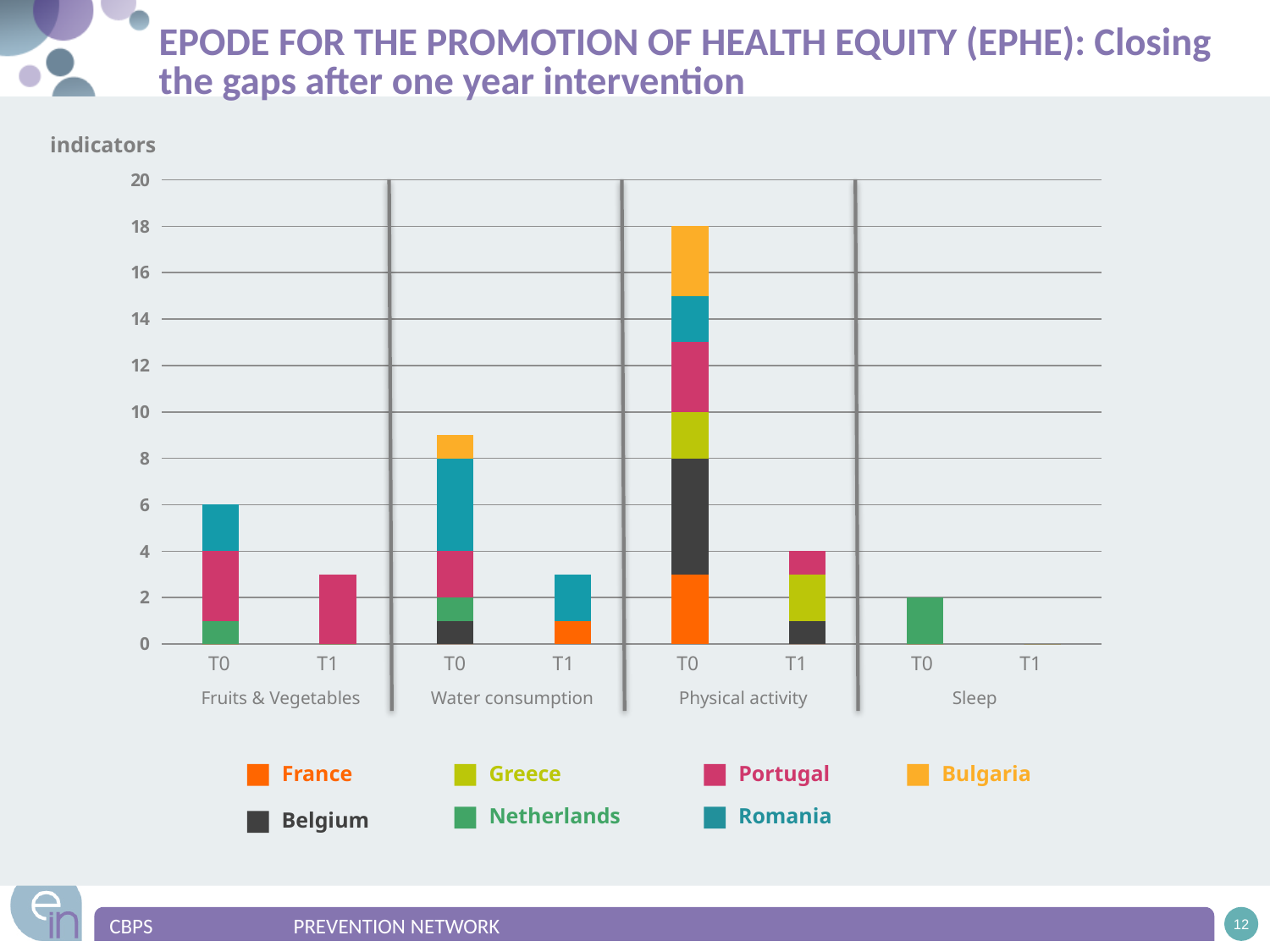
Is the total for Water consumption T0 greater or less than 8? greater What is the total height of the Fruits & Vegetables T0 stacked bar? 6 Which bar is the tallest in the chart? Physical activity T0 Which is larger, the Fruits & Vegetables T0 bar or the Fruits & Vegetables T1 bar? Fruits & Vegetables T0 What is the total height of the Physical activity T0 stacked bar? 18 Is the total for Water consumption T1 greater or less than 4? less How many indicator categories are shown along the x axis? 4 What is the value of the Sleep T0 bar? 2 Which country is represented by the only segment in the Sleep T0 bar? Netherlands How many countries does the legend list? 7 What is the total height of the Physical activity T1 stacked bar? 4 What kind of chart is shown on the slide? Stacked bar chart